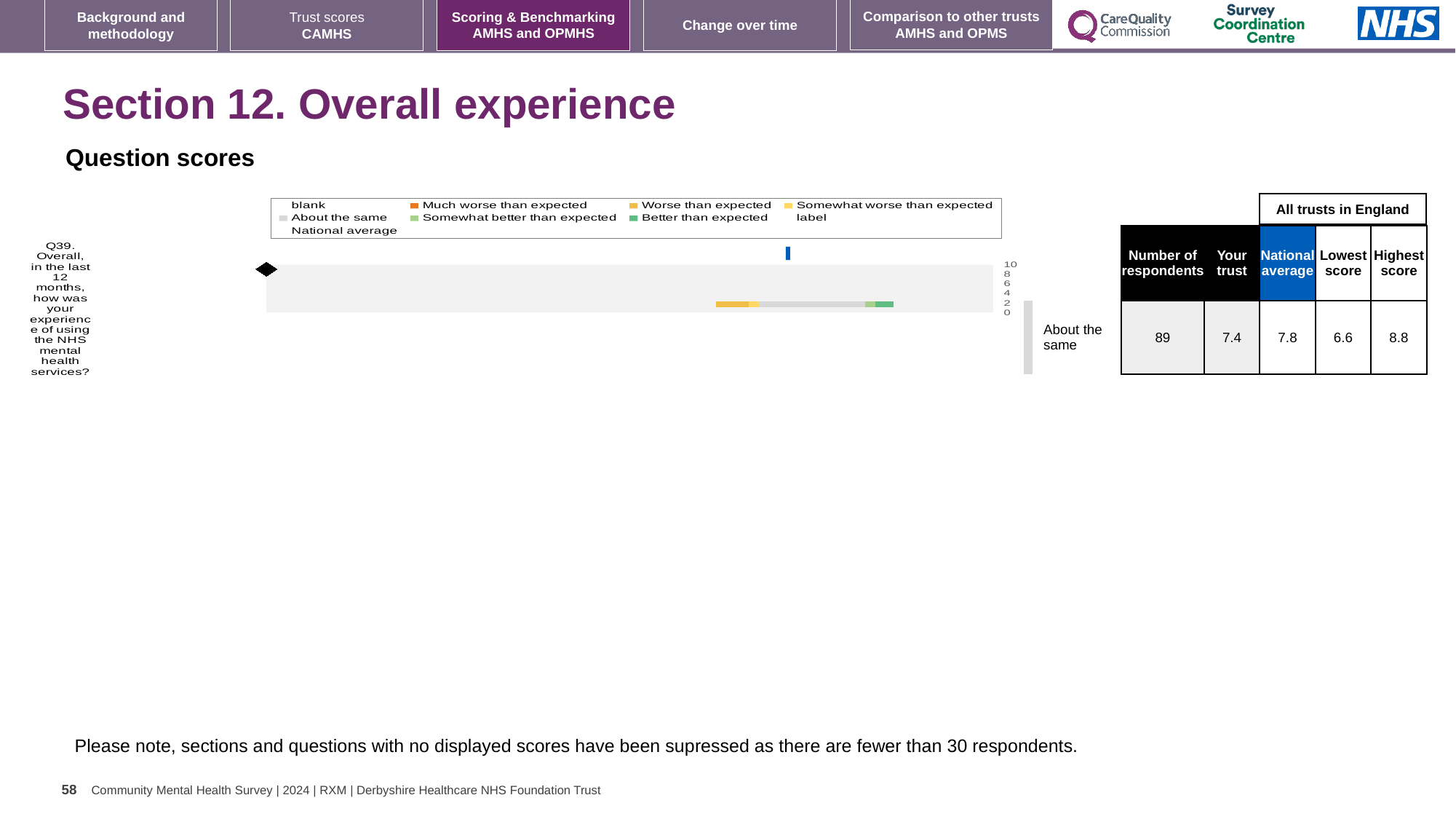
What kind of chart is shown for Q39 on the slide? bar chart What is the national average score for Q39? 7.8 How many questions are plotted in the chart? 1 What is the difference between the national average and the 'Your trust' score for Q39? 0.4 What is the difference between the highest and lowest scores for Q39? 2.2 What is the highest score among all trusts in England for Q39? 8.8 Which is larger for Q39: the 'Your trust' score or the national average? National average What is the 'Your trust' score for Q39? 7.4 How many respondents answered Q39? 89 What is the lowest score among all trusts in England for Q39? 6.6 Is the 'Your trust' score for Q39 greater or less than 8? less What benchmark category is shown for Q39 next to the chart? About the same